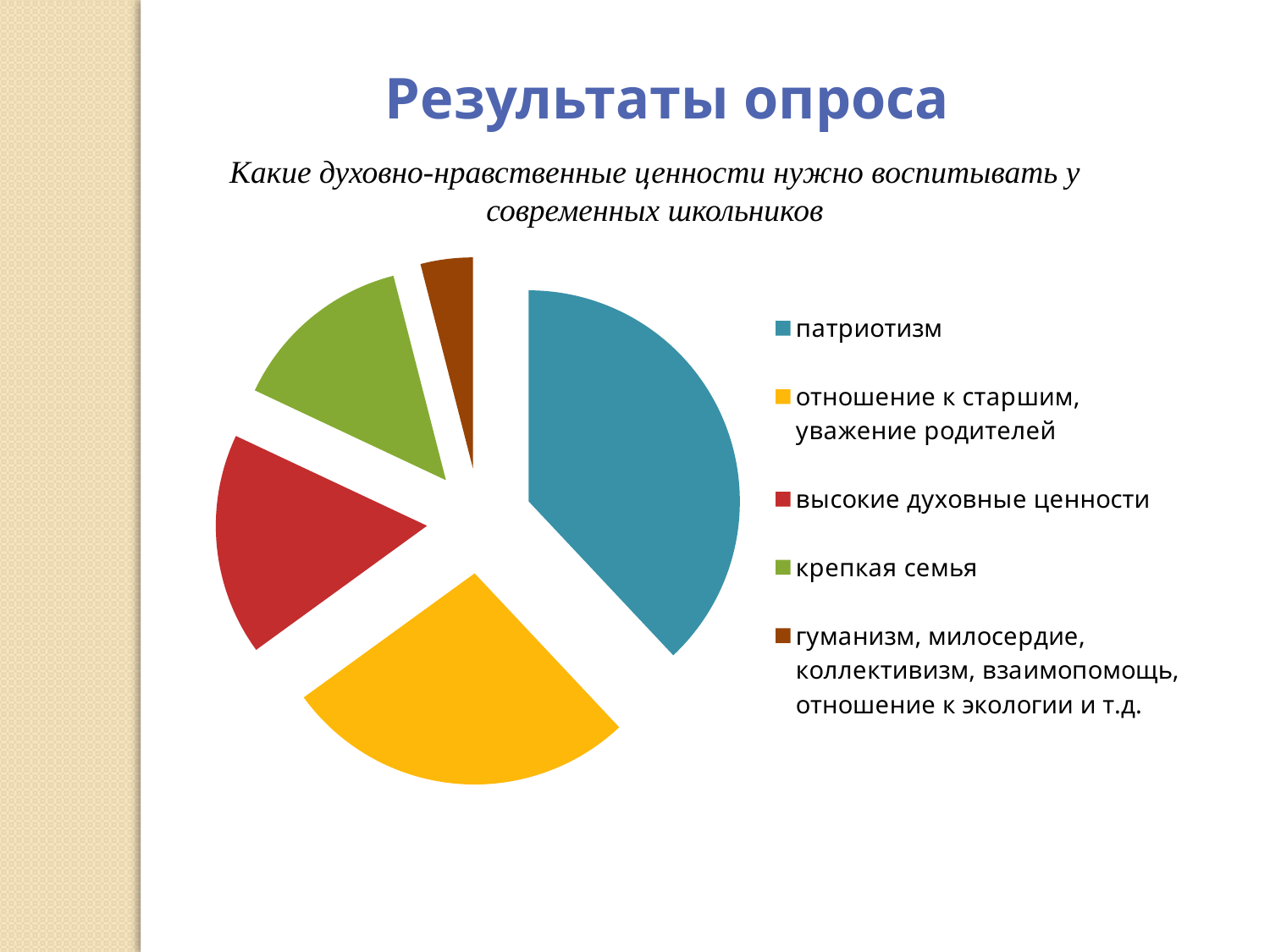
Which category has the largest slice of the pie? патриотизм Which slice is larger: отношение к старшим, уважение родителей or высокие духовные ценности? отношение к старшим, уважение родителей What colour is the slice for высокие духовные ценности? red Which slice is larger: крепкая семья or гуманизм, милосердие, коллективизм, взаимопомощь, отношение к экологии и т.д.? крепкая семья Which category has the smallest slice of the pie? гуманизм, милосердие, коллективизм, взаимопомощь, отношение к экологии и т.д. What is the title of the slide? Результаты опроса How many entries does the legend list? 5 How many slices does the pie chart have? 5 Which slice is larger: патриотизм or крепкая семья? патриотизм What kind of chart is shown on the slide? pie chart